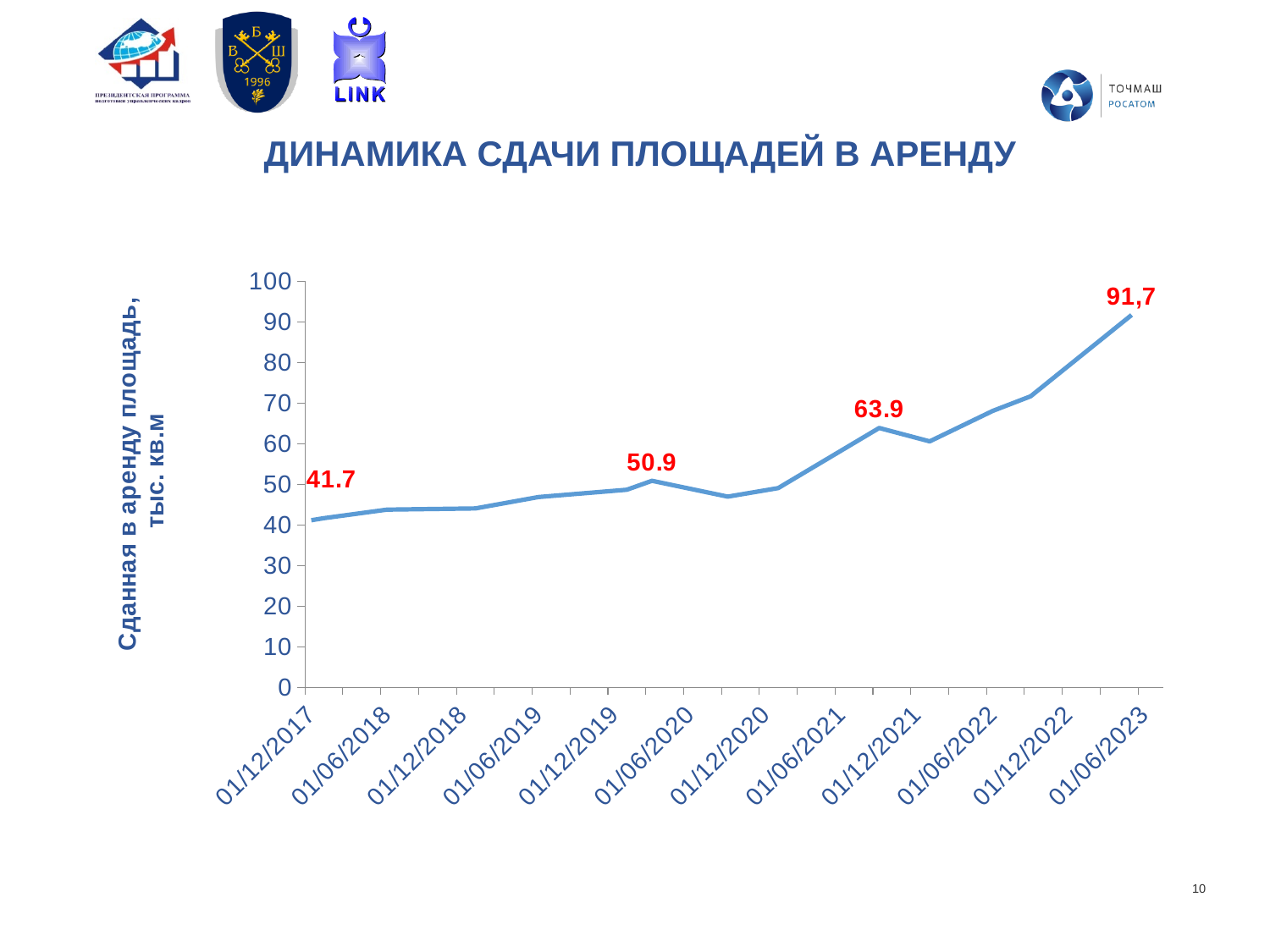
Which date has the lowest value? 01/12/2017 Do the values generally rise or fall from 01/12/2017 to 01/06/2023? rise What kind of chart is shown on the slide? line chart What is the value for 01/06/2023? 91,7 Which is larger, the value for 01/06/2021 or the value for 01/06/2020? 01/06/2021 Is the value for 01/12/2021 greater or less than 70? less Which date has the highest value? 01/06/2023